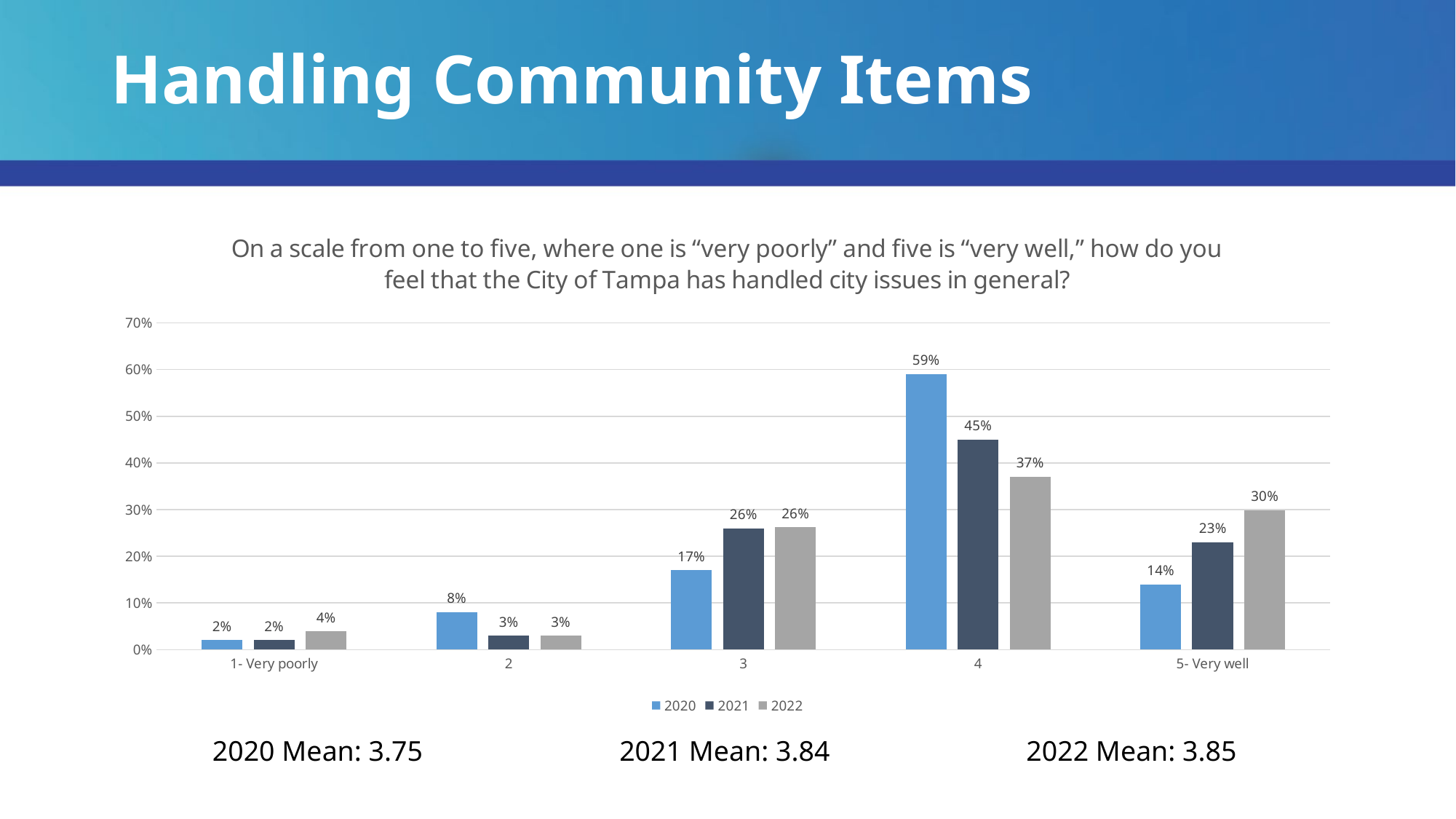
What kind of chart is shown on the slide? Bar chart What percentage of respondents rated the City of Tampa a 4 in 2020? 59% Which category has the lowest value for the 2020 series? 1- Very poorly How many rating categories are shown on the x axis? 5 Which category has the highest value for the 2022 series? 4 Which is larger for the "5- Very well" category: the 2021 value or the 2022 value? 2022 What is the 2022 mean shown below the chart? 3.85 How many series does the legend list? 3 What is the 2022 value for the "5- Very well" category? 30% What is the difference between the 2020 and 2022 values for category 4? 22% What is the 2021 value for category 3? 26%